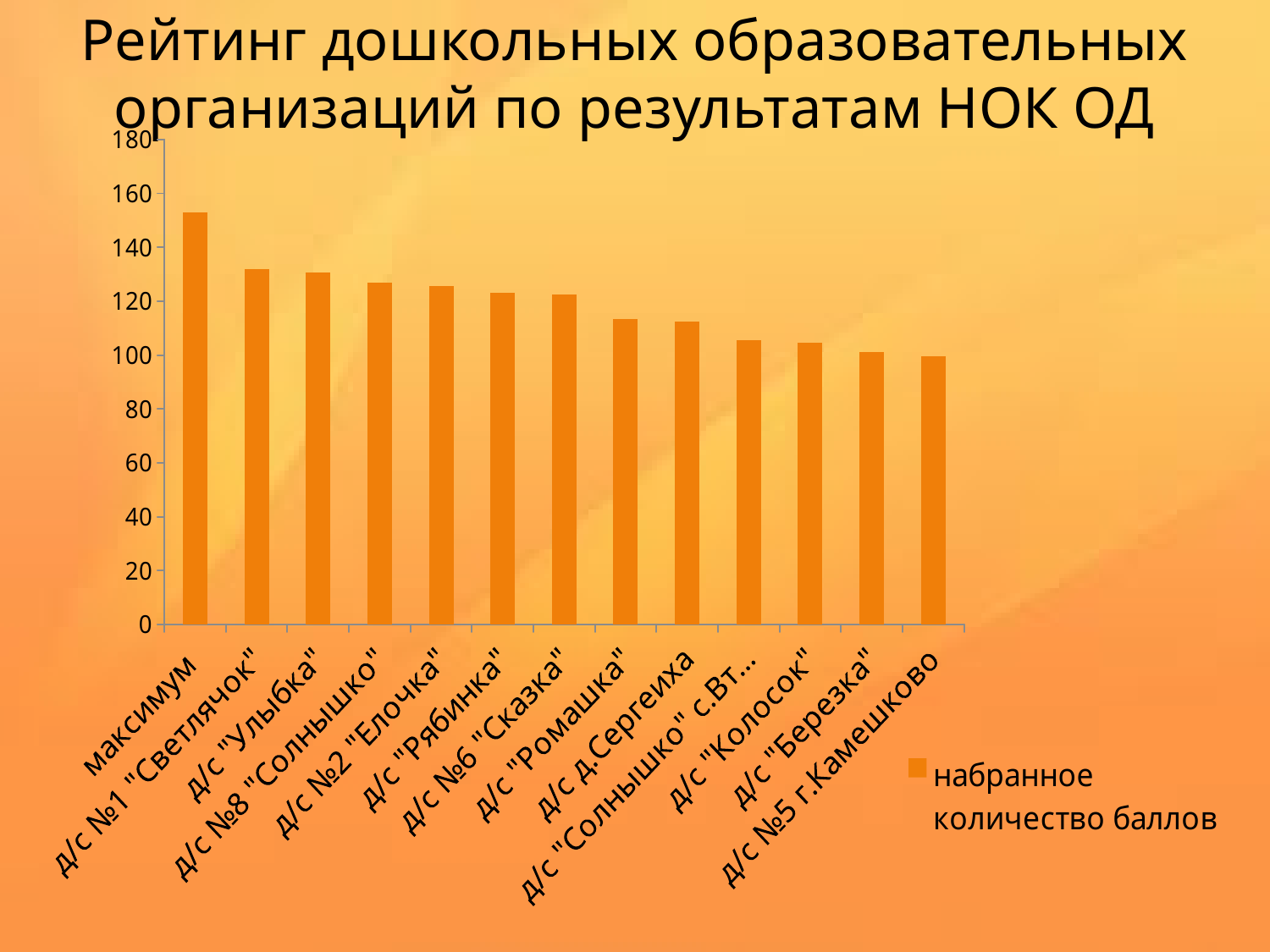
What is the series name shown in the legend? набранное количество баллов Do the values rise or fall moving from left to right along the x axis? fall Which is larger, the value for д/с №1 "Светлячок" or the value for д/с "Ромашка"? д/с №1 "Светлячок" Is the value for максимум greater or less than 140? greater Is the value for д/с №1 "Светлячок" greater or less than 120? greater Is the value for д/с №5 г.Камешково greater or less than 120? less How many series does the legend list? 1 Which category has the highest bar? максимум How many categories are plotted on the x axis? 13 Which is larger, the value for д/с №6 "Сказка" or the value for д/с "Березка"? д/с №6 "Сказка" What kind of chart is shown on the slide? bar chart